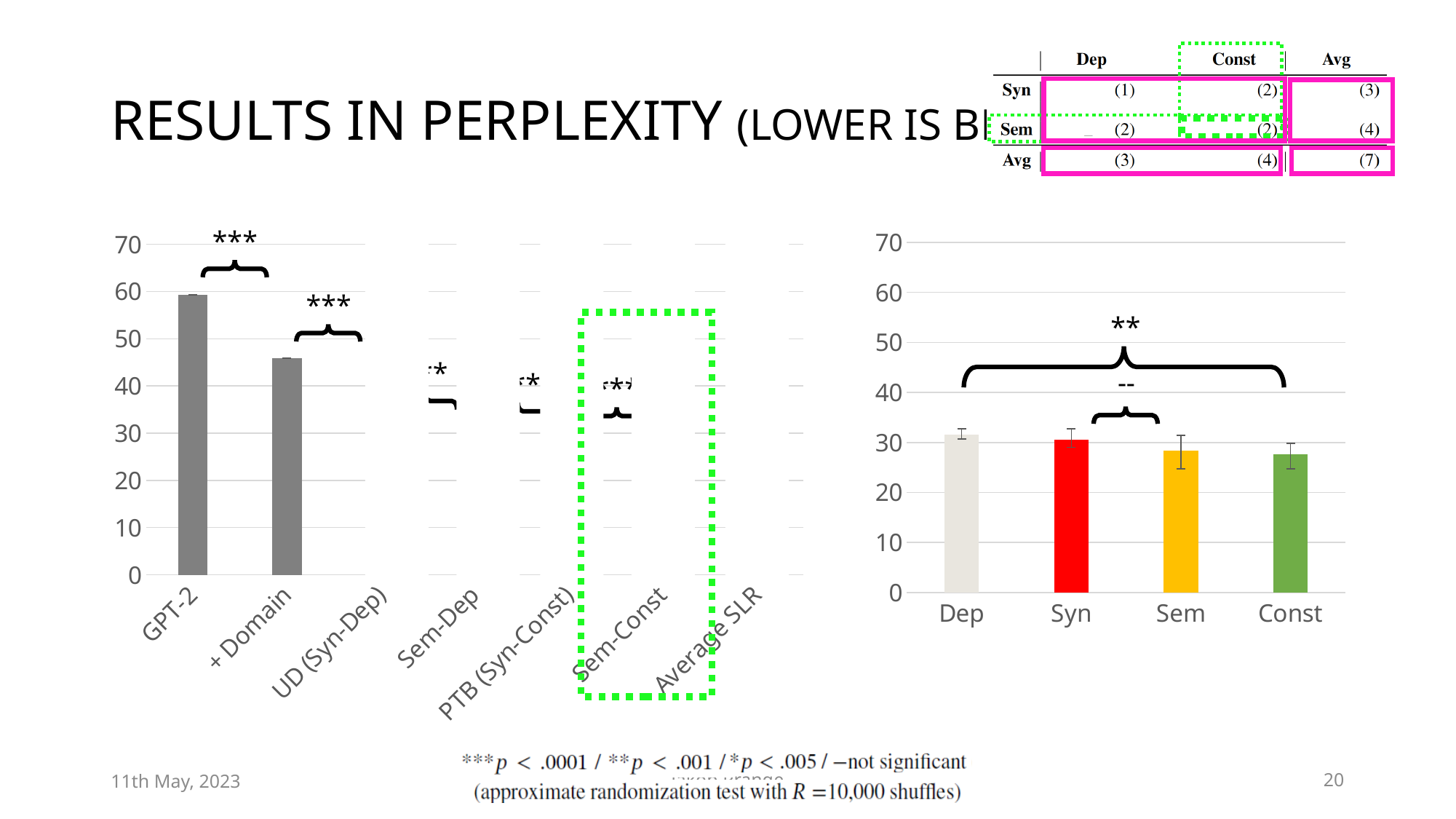
In the right chart, which is larger, the value for Dep or the value for Const? Dep In the right chart, what colour is the bar for Syn? red In the left chart, is the value for GPT-2 greater or less than 50? greater In the right chart, do the bar values rise or fall from Dep to Const along the x axis? fall How many categories are labelled on the x axis of the left chart? 7 In the right chart, is the value for Dep greater or less than 30? greater In the right chart, is the value for Const greater or less than 30? less In the left chart, which is larger, the value for GPT-2 or the value for + Domain? GPT-2 How many categories are shown in the right chart? 4 What kind of chart is the chart on the right of the slide (Dep, Syn, Sem, Const)? bar chart